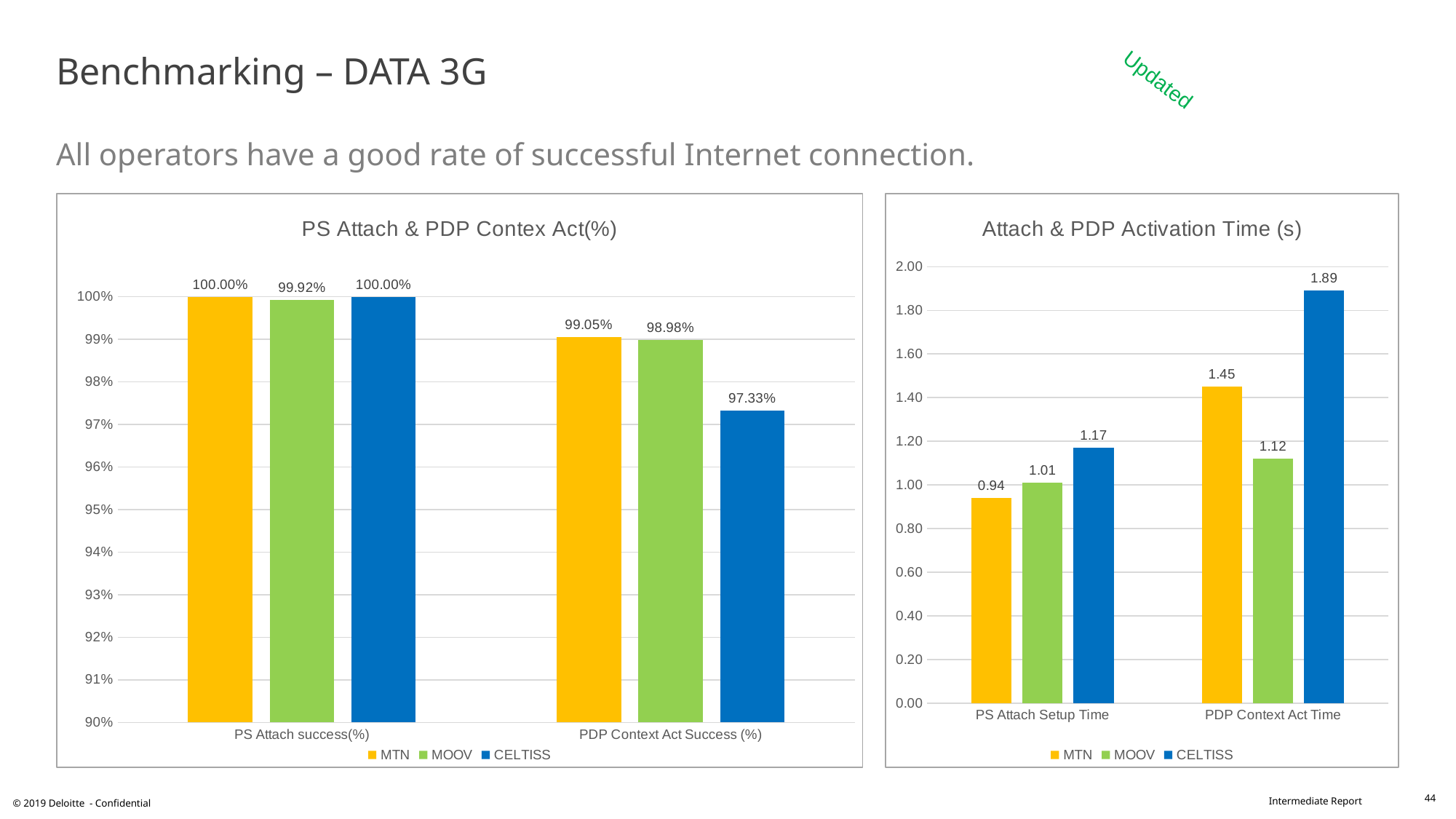
In the 'PS Attach & PDP Contex Act(%)' chart, what is the difference between MTN and CELTISS in PDP Context Act Success (%)? 1.72% In the 'PS Attach & PDP Contex Act(%)' chart, which operator has the lowest PDP Context Act Success (%)? CELTISS In the 'PS Attach & PDP Contex Act(%)' chart, how many series does the legend list? 3 In the 'Attach & PDP Activation Time (s)' chart, what is the PDP Context Act Time for CELTISS? 1.89 In the 'Attach & PDP Activation Time (s)' chart, which is larger: MTN's PDP Context Act Time or MOOV's PDP Context Act Time? MTN In the 'Attach & PDP Activation Time (s)' chart, what is the difference between CELTISS and MTN in PS Attach Setup Time? 0.23 In the 'PS Attach & PDP Contex Act(%)' chart, what is the value for MOOV in PS Attach success(%)? 99.92% In the 'PS Attach & PDP Contex Act(%)' chart, what is the value for CELTISS in PDP Context Act Success (%)? 97.33% In the 'Attach & PDP Activation Time (s)' chart, which operator has the highest PDP Context Act Time? CELTISS In the 'Attach & PDP Activation Time (s)' chart, how many categories are shown on the x axis? 2 What kind of chart is the 'Attach & PDP Activation Time (s)' chart? Bar chart In the 'Attach & PDP Activation Time (s)' chart, what is the PS Attach Setup Time for MTN? 0.94